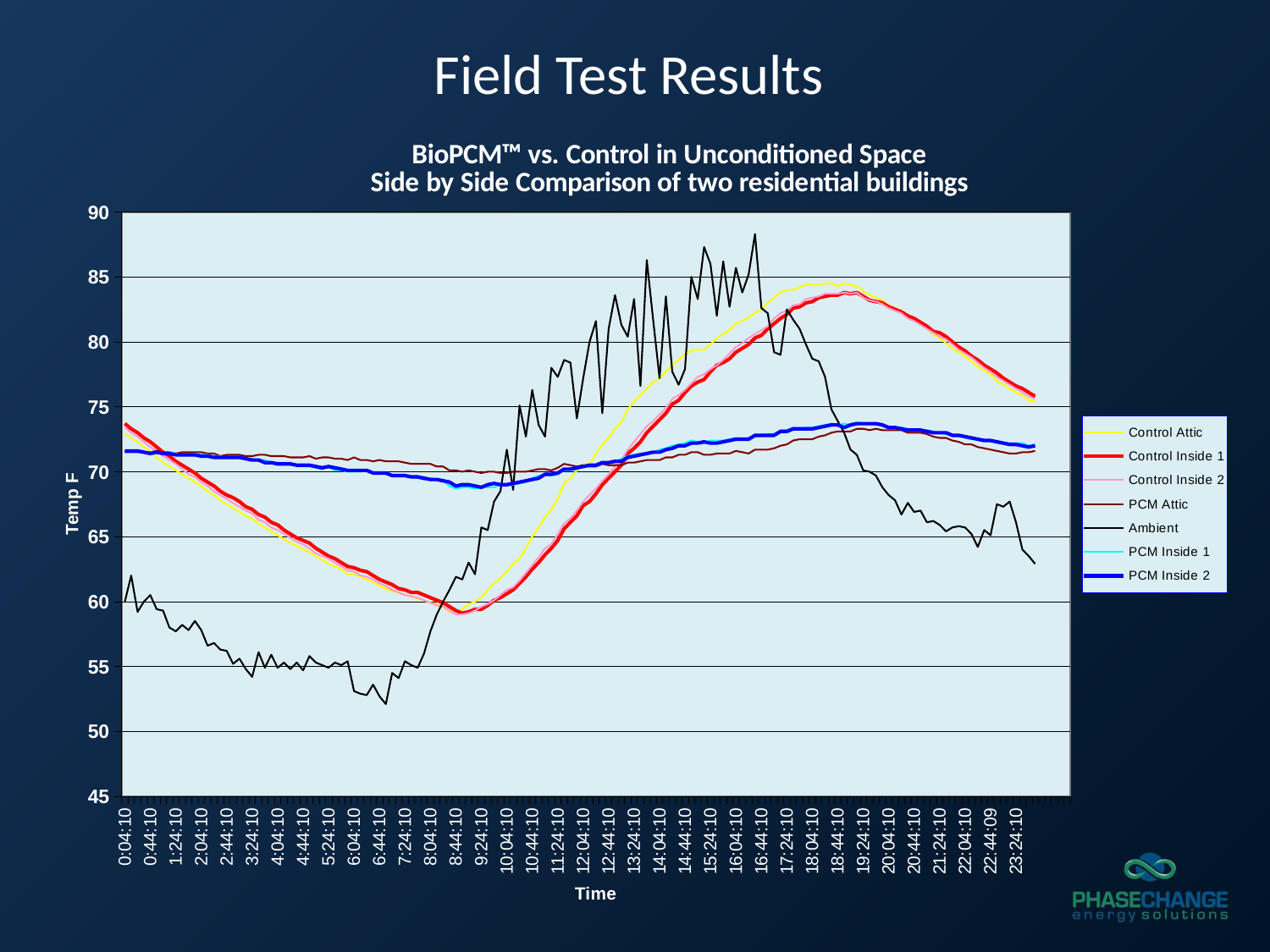
Does the Control Attic series rise or fall between 0:04:10 and 8:44:10? fall How many series does the legend list? 7 Which series drops to the lowest temperature on the chart? Ambient Which series is drawn in black? Ambient What kind of chart is shown on the slide? Line chart At 12:04:10, which is higher: Control Attic or Control Inside 1? Control Attic Is the Ambient value at 6:44:10 greater or less than 55? less Which series reaches the highest temperature on the chart? Ambient What is the label of the vertical axis? Temp F Is the Control Attic value at 19:24:10 greater or less than 80? greater At 3:24:10, which is higher: Ambient or PCM Attic? PCM Attic